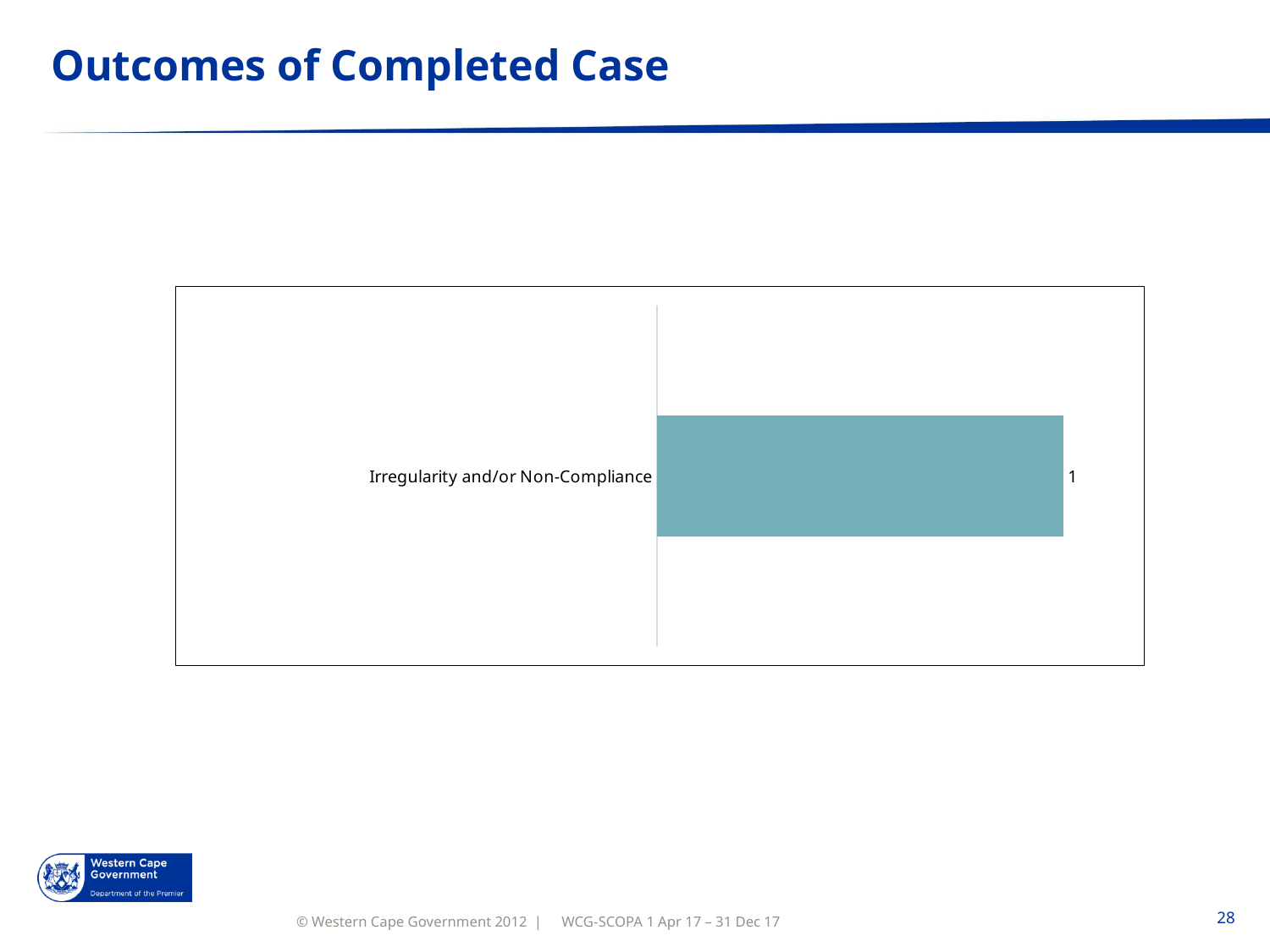
Are the bars in the chart horizontal or vertical? horizontal What kind of chart is shown on the slide? bar chart How many categories are plotted in the chart? 1 What is the value for Irregularity and/or Non-Compliance? 1 What is the title of the slide containing the chart? Outcomes of Completed Case What is the label of the only category shown in the chart? Irregularity and/or Non-Compliance